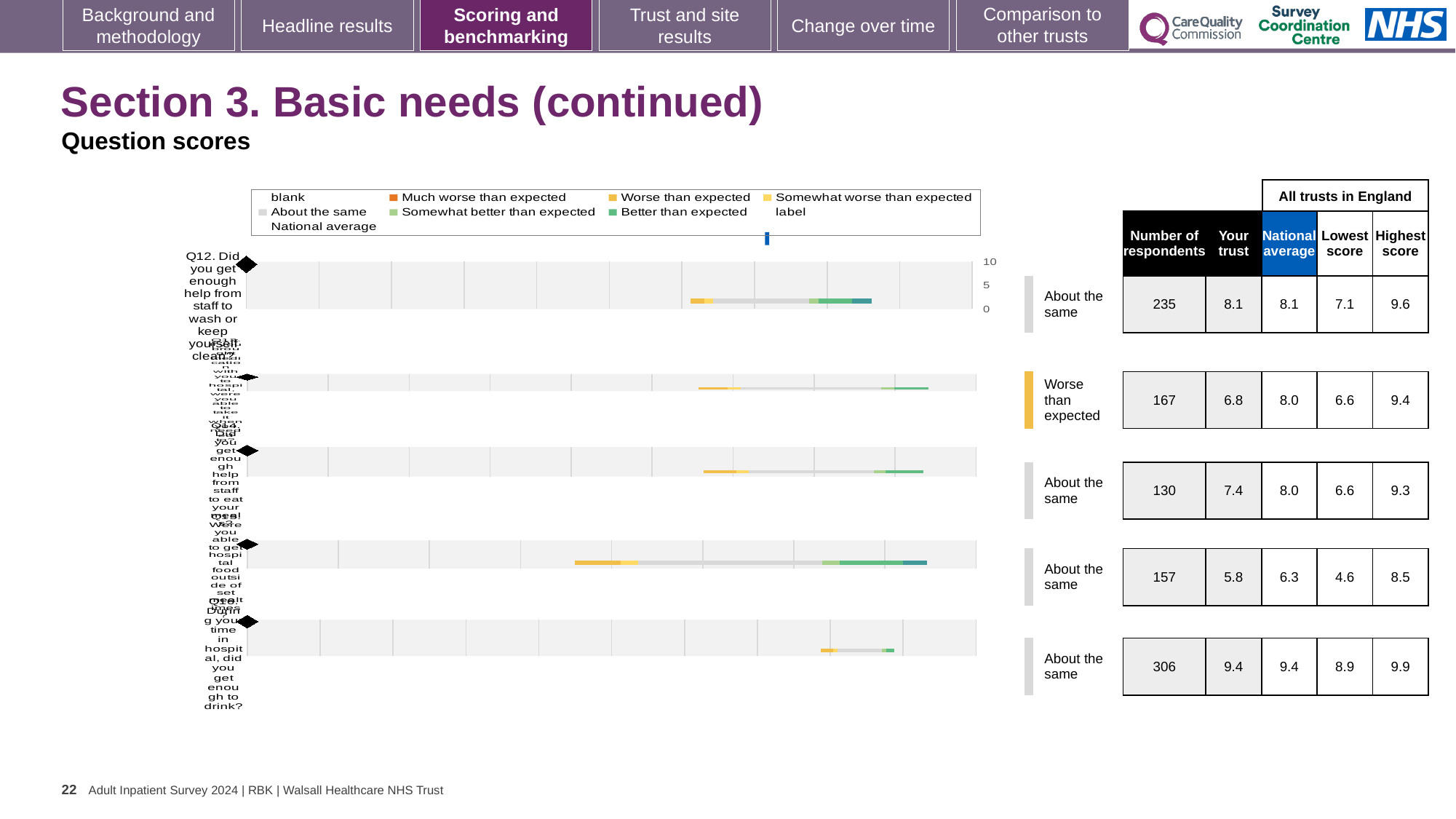
How many question rows are plotted in the chart? 5 What is the 'Your trust' score for Q12 (Did you get enough help from staff to wash or keep yourself clean?)? 8.1 Which question row is rated 'Worse than expected'? Q13 (the second row) Which question row has the lowest 'Your trust' score? Q15 (Were you able to get hospital food outside of set meal times?) What kind of chart is used to show the question scores on this slide? bar chart For the second row (Q13), what is the difference between the national average and the 'Your trust' score? 1.2 Which question row has the highest 'Your trust' score? Q16 (During your time in hospital, did you get enough to drink?) What is the highest score across all trusts in England for Q15 (Were you able to get hospital food outside of set meal times?)? 8.5 What colour does the legend use for 'Better than expected'? green How many respondents are shown for Q16 (During your time in hospital, did you get enough to drink?)? 306 For Q14 (Did you get enough help from staff to eat your meals?), which is larger: the 'Your trust' score or the national average? National average